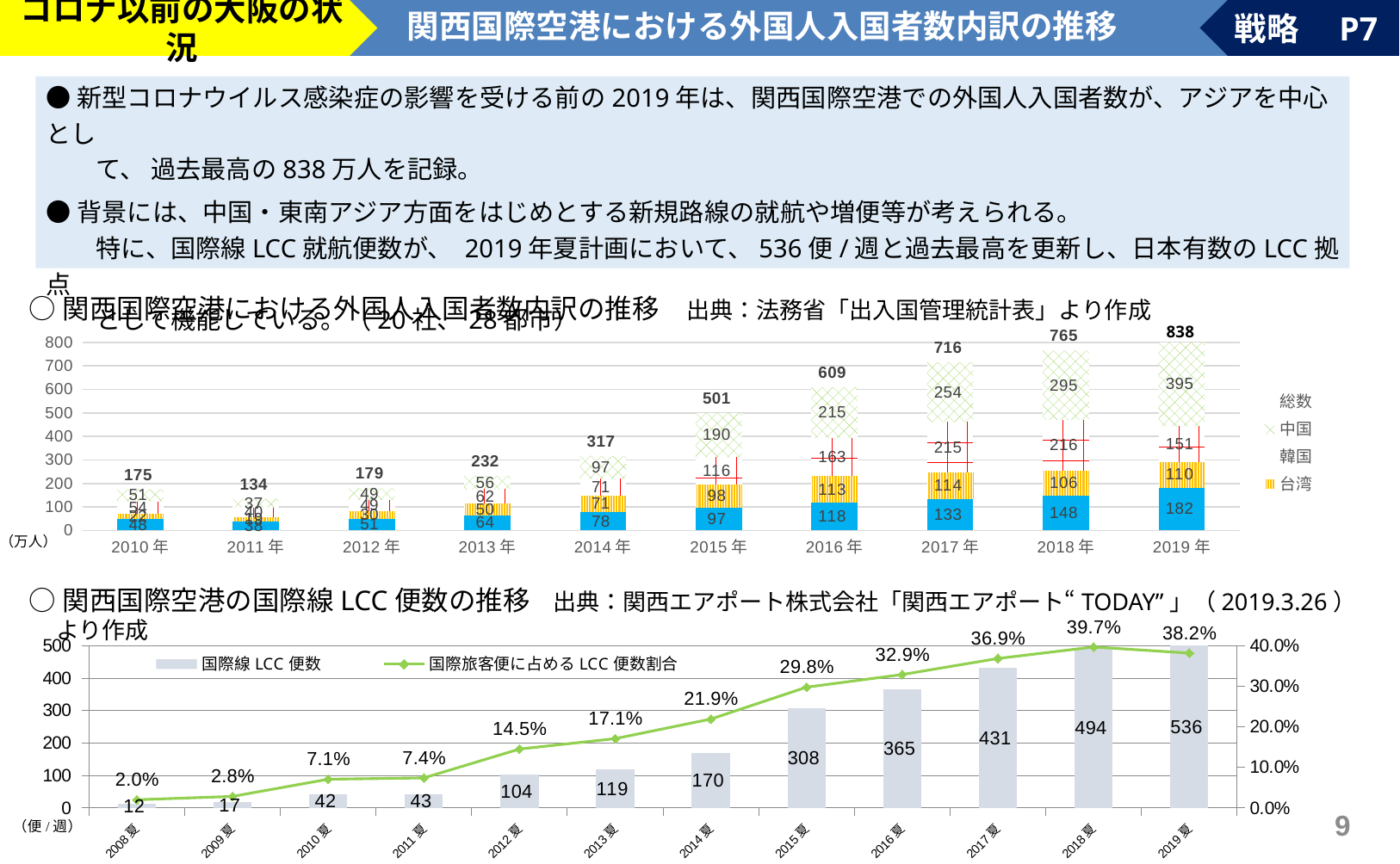
In the bottom chart (関西国際空港の国際線LCC便数の推移), which period has the highest 国際旅客便に占めるLCC便数割合? 2018夏 In the top chart (関西国際空港における外国人入国者数内訳の推移), which year has the lowest total (総数)? 2011年 In the top chart (関西国際空港における外国人入国者数内訳の推移), which is larger in 2018年, the value for 中国 or the value for 韓国? 中国 In the top chart (関西国際空港における外国人入国者数内訳の推移), what is the total (総数) for 2019年? 838 In the bottom chart (関西国際空港の国際線LCC便数の推移), what is the difference in 国際線LCC便数 between 2015夏 and 2014夏? 138 In the top chart (関西国際空港における外国人入国者数内訳の推移), what is the value for 台湾 in 2016年? 113 In the bottom chart (関西国際空港の国際線LCC便数の推移), how many periods are shown on the x axis? 12 In the top chart (関西国際空港における外国人入国者数内訳の推移), what is the value for 中国 in 2017年? 254 In the top chart (関西国際空港における外国人入国者数内訳の推移), how many entries does the legend list? 4 In the top chart (関西国際空港における外国人入国者数内訳の推移), what is the difference between the 2019年 total and the 2018年 total? 73 In the bottom chart (関西国際空港の国際線LCC便数の推移), what is the 国際旅客便に占めるLCC便数割合 for 2018夏? 39.7% In the bottom chart (関西国際空港の国際線LCC便数の推移), what is the number of 国際線LCC便数 for 2019夏? 536